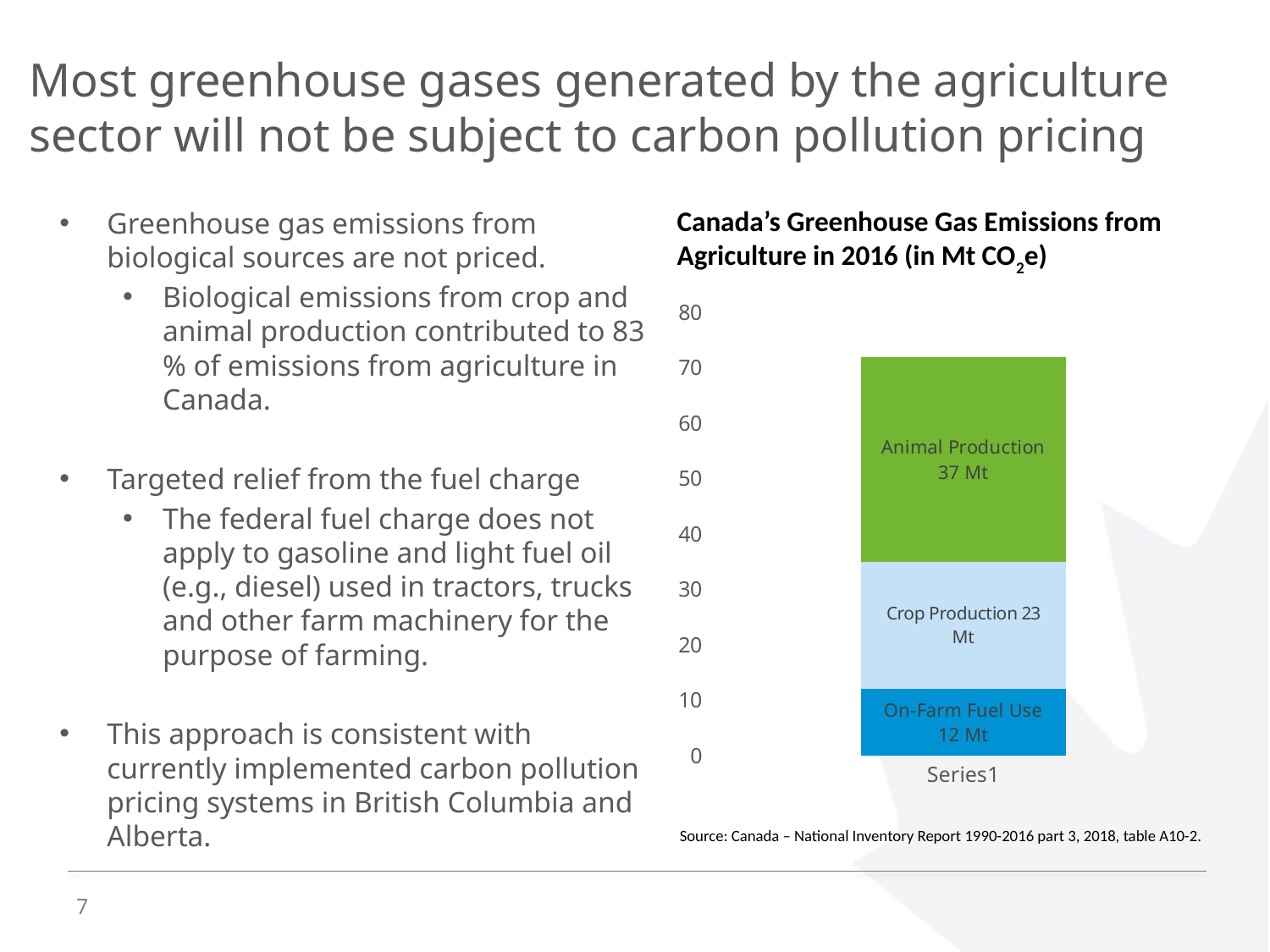
What is the difference between Crop Production and On-Farm Fuel Use emissions? 11 Mt How many segments make up the stacked bar? 3 What is the value for On-Farm Fuel Use? 12 Mt Which segment of the stacked bar is the largest? Animal Production What is the title of the chart? Canada's Greenhouse Gas Emissions from Agriculture in 2016 (in Mt CO2e) What is the total of the stacked bar? 72 Mt Which segment of the stacked bar is the smallest? On-Farm Fuel Use What is the value for Crop Production? 23 Mt Which is larger, Crop Production or On-Farm Fuel Use? Crop Production What is the value for Animal Production? 37 Mt What kind of chart is shown on the slide? Stacked bar chart What is the difference between Animal Production and Crop Production emissions? 14 Mt